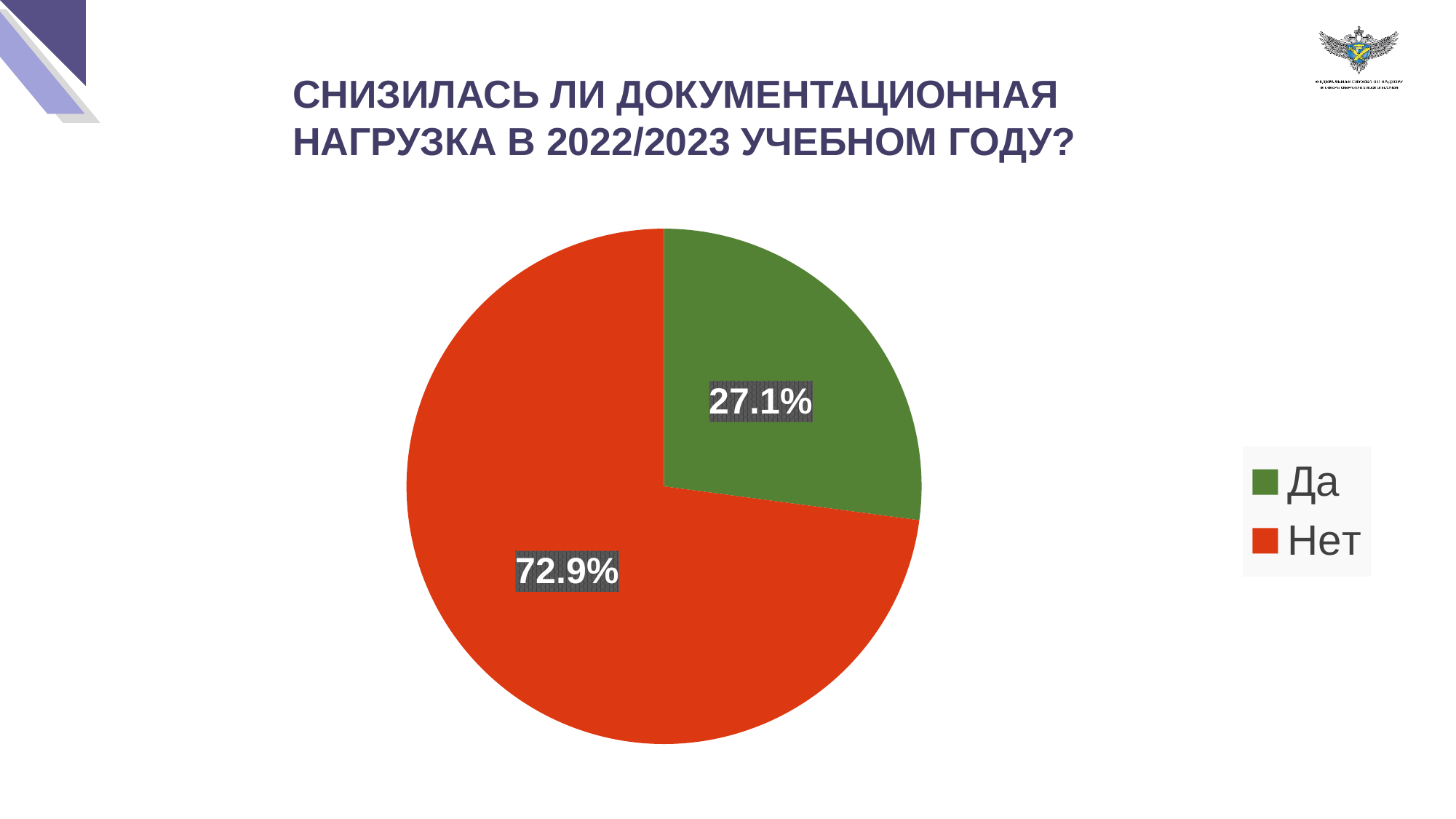
Which answer has the largest slice of the pie? Нет Which answer has the smallest slice of the pie? Да Which slice is larger, "Да" or "Нет"? Нет What share of respondents answered "Да"? 27.1% What share of respondents answered "Нет"? 72.9% What kind of chart is shown on the slide? pie chart What colour is the "Да" slice? green What is the difference in percentage points between the "Нет" and "Да" slices? 45.8 How many slices does the pie chart have? 2 What colour is the "Нет" slice? red How many entries does the legend list? 2